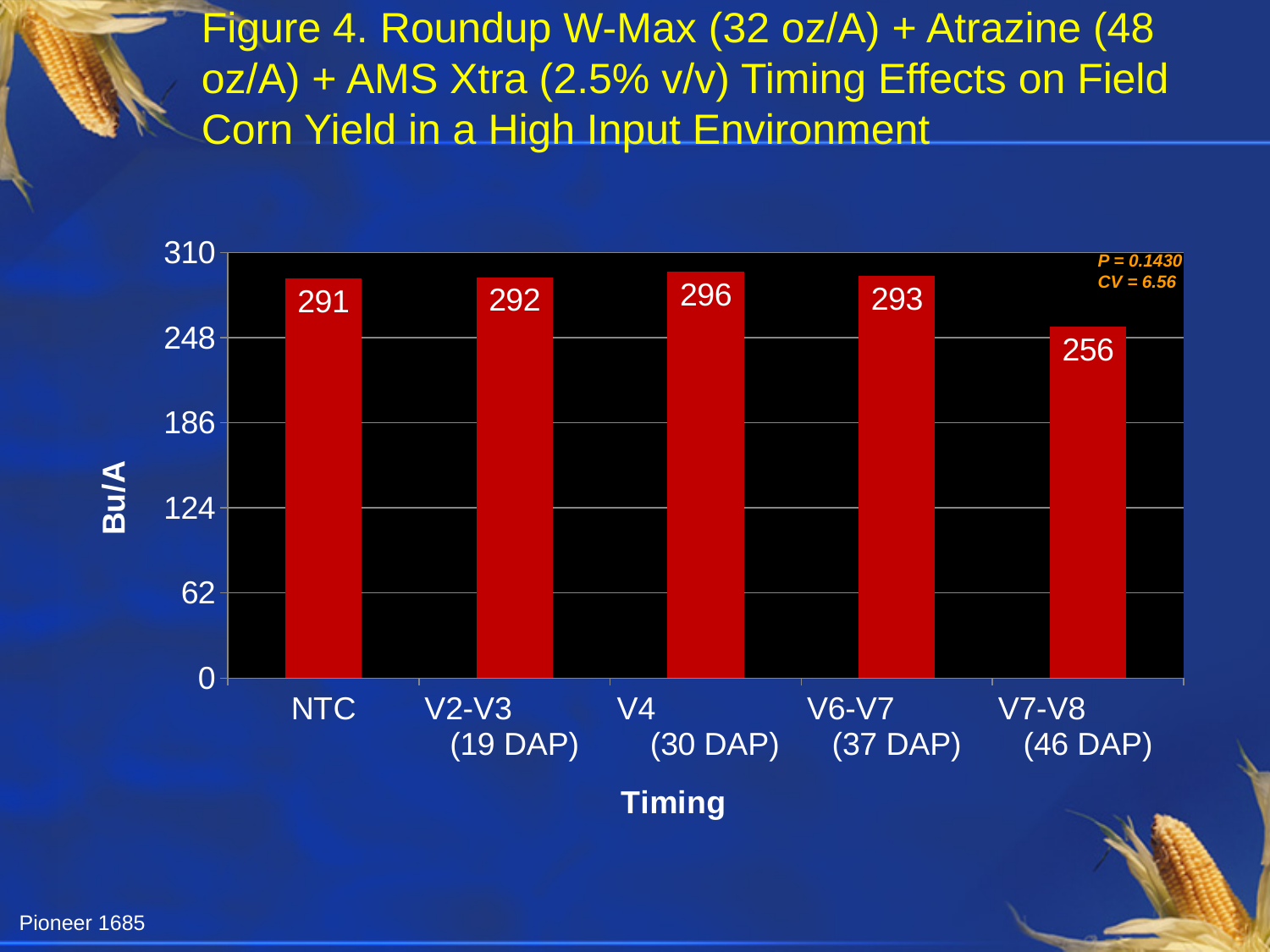
How many timing categories are shown on the chart? 5 Which timing has the lowest yield? V7-V8 (46 DAP) What is the difference in yield between the V4 (30 DAP) timing and the V7-V8 (46 DAP) timing? 40 What is the yield (Bu/A) for the V4 (30 DAP) timing? 296 What kind of chart is shown on the slide? bar chart Is the yield for the V7-V8 (46 DAP) timing greater or less than 248? greater What is the label of the y axis? Bu/A What is the yield (Bu/A) for the V7-V8 (46 DAP) timing? 256 Which has a larger yield, V2-V3 (19 DAP) or V7-V8 (46 DAP)? V2-V3 (19 DAP) What is the difference in yield between the V6-V7 (37 DAP) timing and the NTC timing? 2 What is the yield (Bu/A) for the NTC timing? 291 Which timing has the highest yield? V4 (30 DAP)